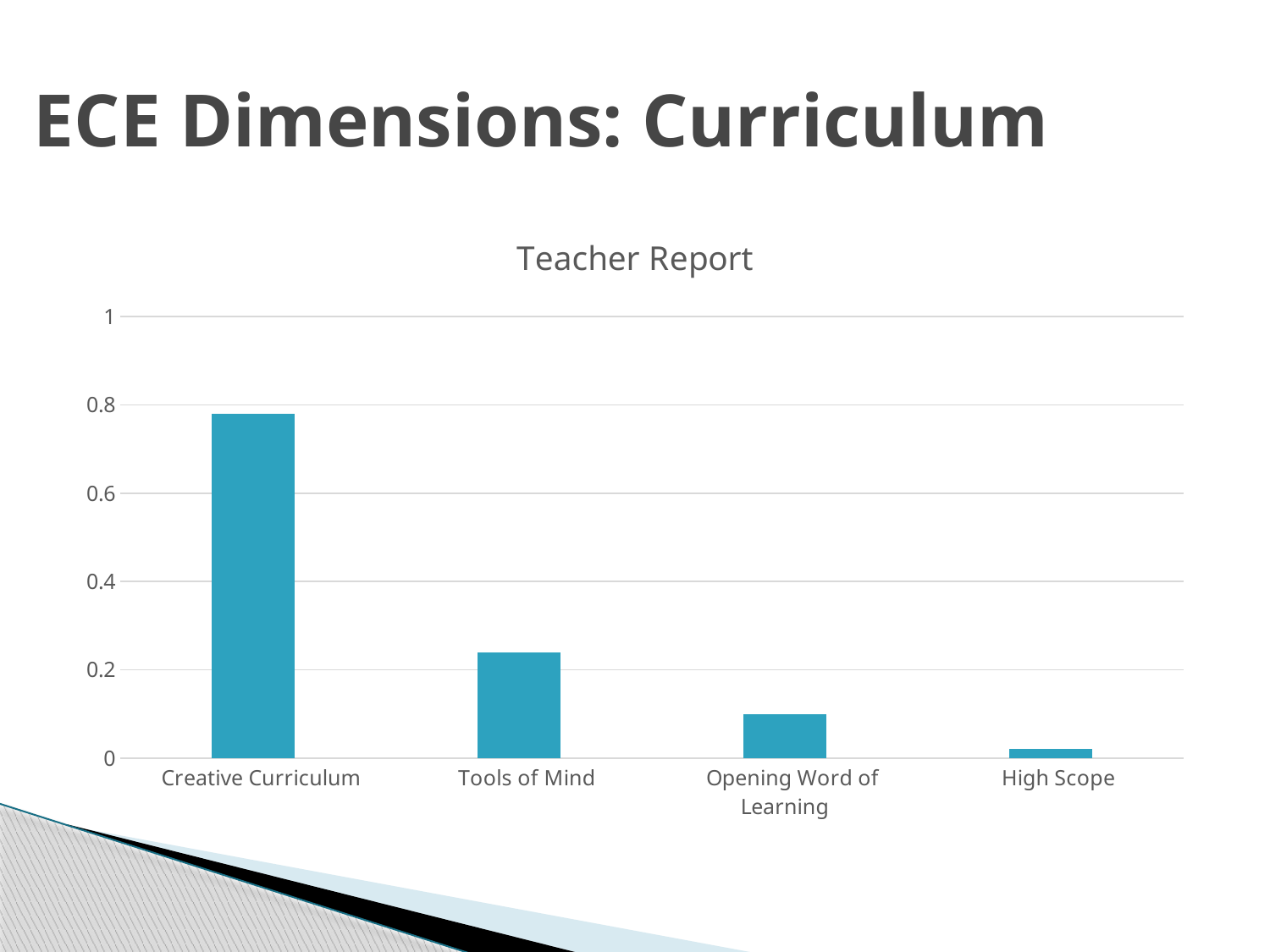
Do the values rise or fall moving from left to right along the x axis? fall What type of chart is shown on the slide? bar chart Which is larger, the value for Tools of Mind or the value for Opening Word of Learning? Tools of Mind How many categories are shown on the x axis of the chart? 4 Is the value for Opening Word of Learning greater or less than 0.2? less Which category has the lowest value in the chart? High Scope Is the value for Tools of Mind greater or less than 0.4? less What is the title of the chart? Teacher Report Is the value for Creative Curriculum greater or less than 0.6? greater Which category has the highest value in the chart? Creative Curriculum What is the highest value shown on the vertical axis of the chart? 1